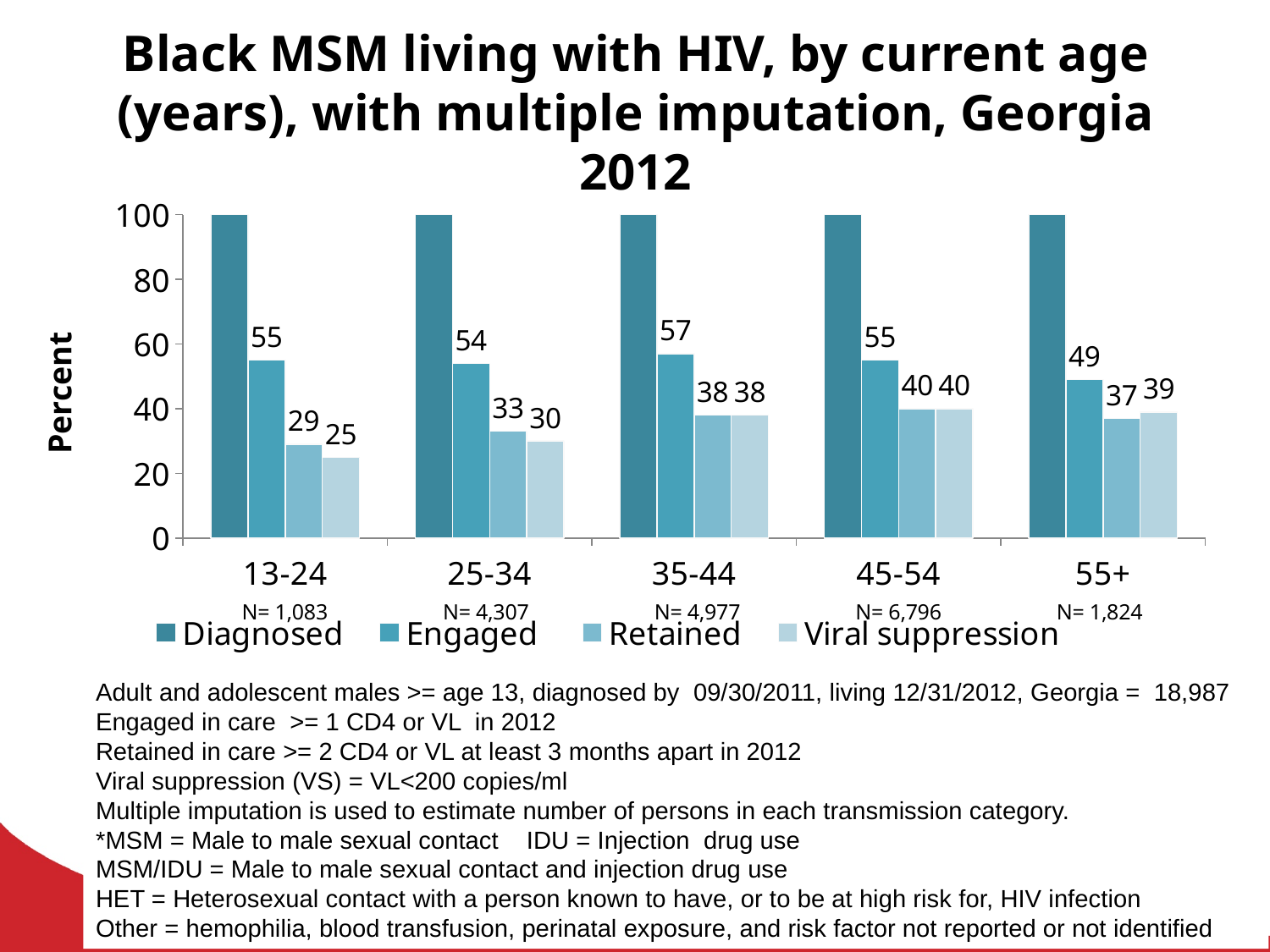
Which age group has the highest Engaged value? 35-44 What is the Diagnosed value for each age group? 100 Which age group has the lowest Engaged value? 55+ What kind of chart is shown on the slide? Bar chart What is the difference between the Engaged and Retained values for the 13-24 age group? 26 What is the label on the y axis? Percent How many age groups are shown on the x axis? 5 Which is larger for the 55+ age group, Retained or Viral suppression? Viral suppression What is the Retained value for the 45-54 age group? 40 What is the Viral suppression value for the 13-24 age group? 25 What is the Engaged value for the 35-44 age group? 57 How many series does the legend list? 4